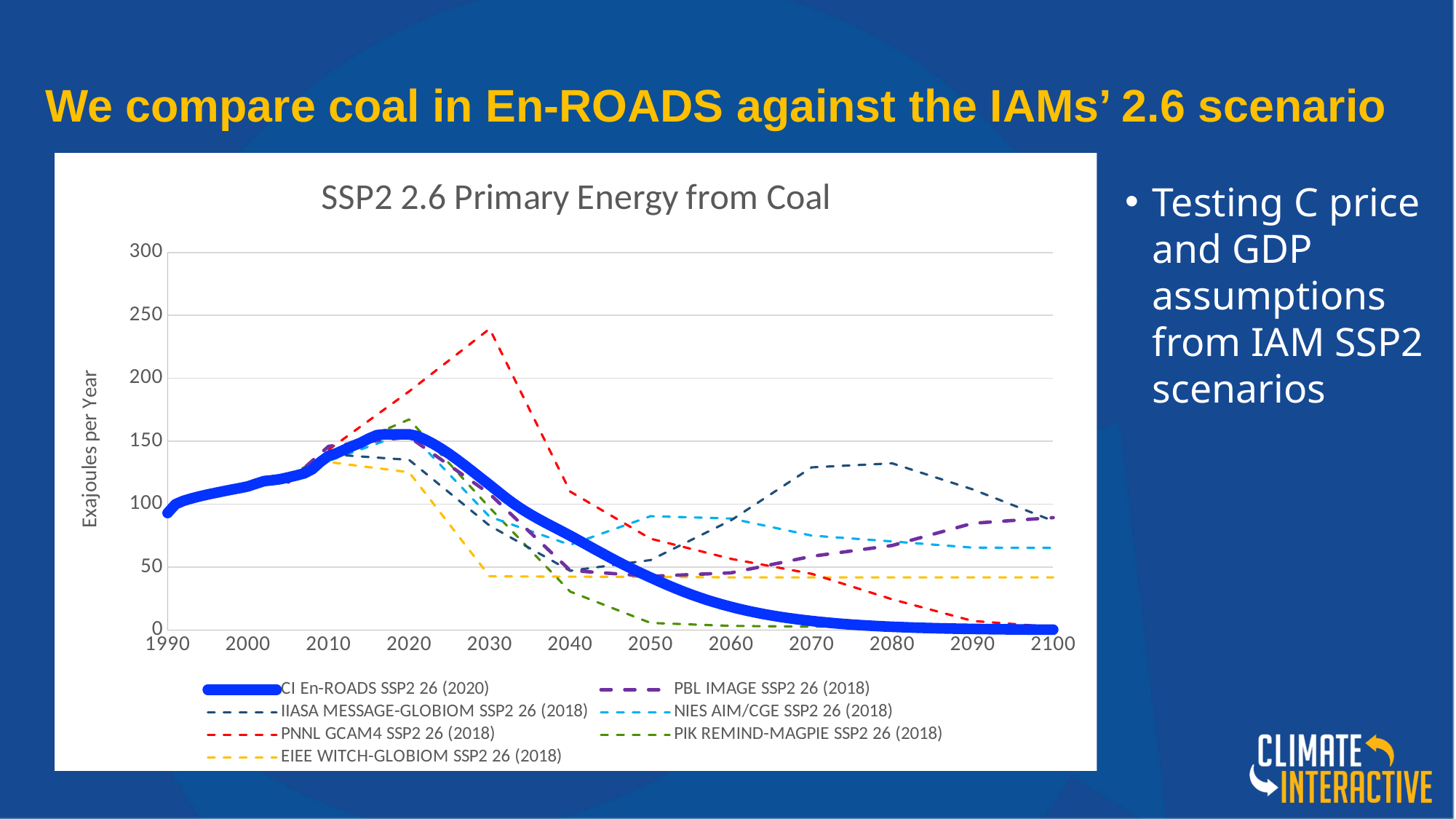
In 2080, which series has the larger value: IIASA MESSAGE-GLOBIOM SSP2 26 (2018) or PBL IMAGE SSP2 26 (2018)? IIASA MESSAGE-GLOBIOM SSP2 26 (2018) Is the value for CI En-ROADS SSP2 26 (2020) in 2100 greater or less than 50? less How many year labels are shown along the x axis of the chart? 12 What kind of chart is shown on the slide? line chart What is the label of the vertical axis of the chart? Exajoules per Year Is the value for PIK REMIND-MAGPIE SSP2 26 (2018) in 2060 greater or less than 50? less How many series does the chart's legend list? 7 Is the value for PNNL GCAM4 SSP2 26 (2018) in 2030 greater or less than 200? greater What is the title of the chart on the slide? SSP2 2.6 Primary Energy from Coal Does the CI En-ROADS SSP2 26 (2020) series rise or fall between 2020 and 2100? fall Which series reaches the highest value on the chart? PNNL GCAM4 SSP2 26 (2018)